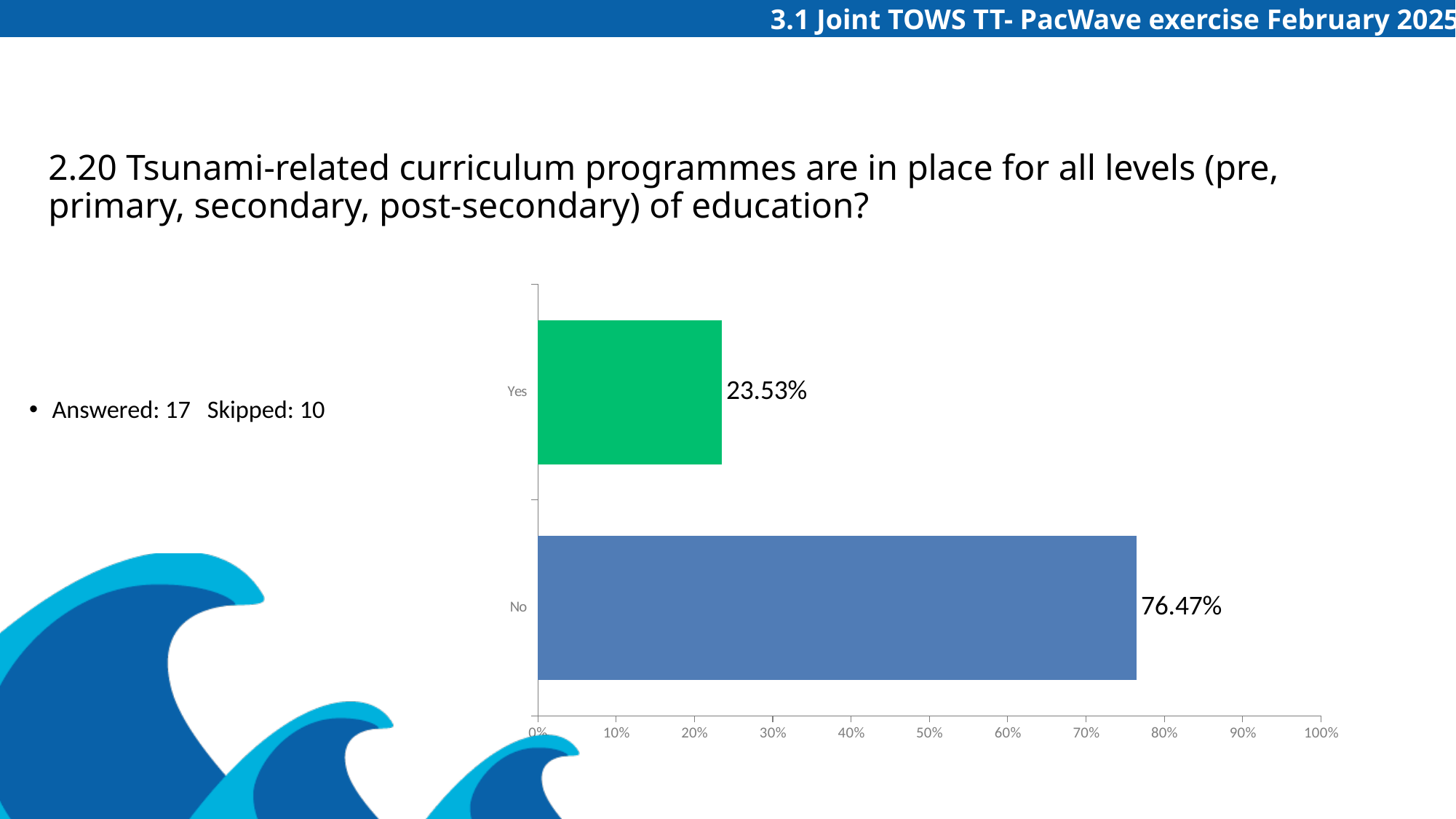
What colour is the bar for Yes? green Which category has the lowest value? Yes Is the value for No greater or less than 70%? greater What kind of chart is shown on the slide? bar chart Is the value for Yes greater or less than 30%? less Which is larger, the value for Yes or the value for No? No Which category has the highest value? No How many categories are shown in the chart? 2 What is the value for Yes? 23.53% What is the value for No? 76.47% What is the difference between the values for No and Yes? 52.94% What is the maximum value shown on the x axis? 100%